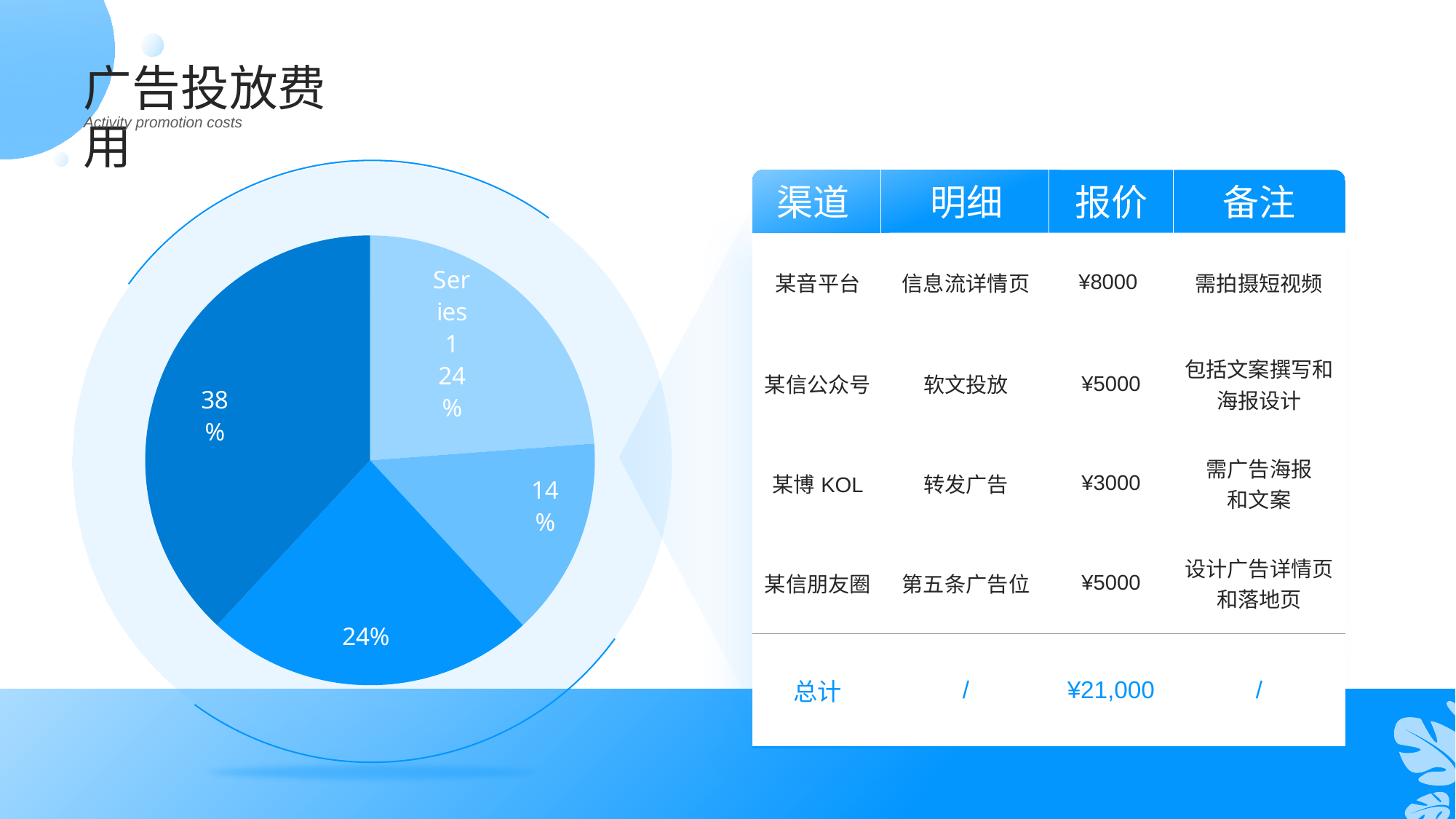
What is the difference in percentage points between the largest slice (38%) and the smallest slice (14%) of the pie chart? 24 How many slices does the pie chart have? 4 What is the largest percentage shown on the pie chart? 38% What kind of chart is shown on the left of the slide? pie chart Which slice of the pie chart carries the text label "Series 1"? the light blue 24% slice at the top right Which is larger on the pie chart: the dark blue slice on the left or the slice on the right labelled 14%? the dark blue slice on the left (38%) What is the total of all the percentage labels on the pie chart? 100% Is the largest slice of the pie chart greater or less than 50%? less How many slices of the pie chart are labelled 24%? 2 What percentage is shown on the pie slice labelled "Series 1"? 24% What colour is the 38% slice of the pie chart? dark blue What is the smallest percentage shown on the pie chart? 14%